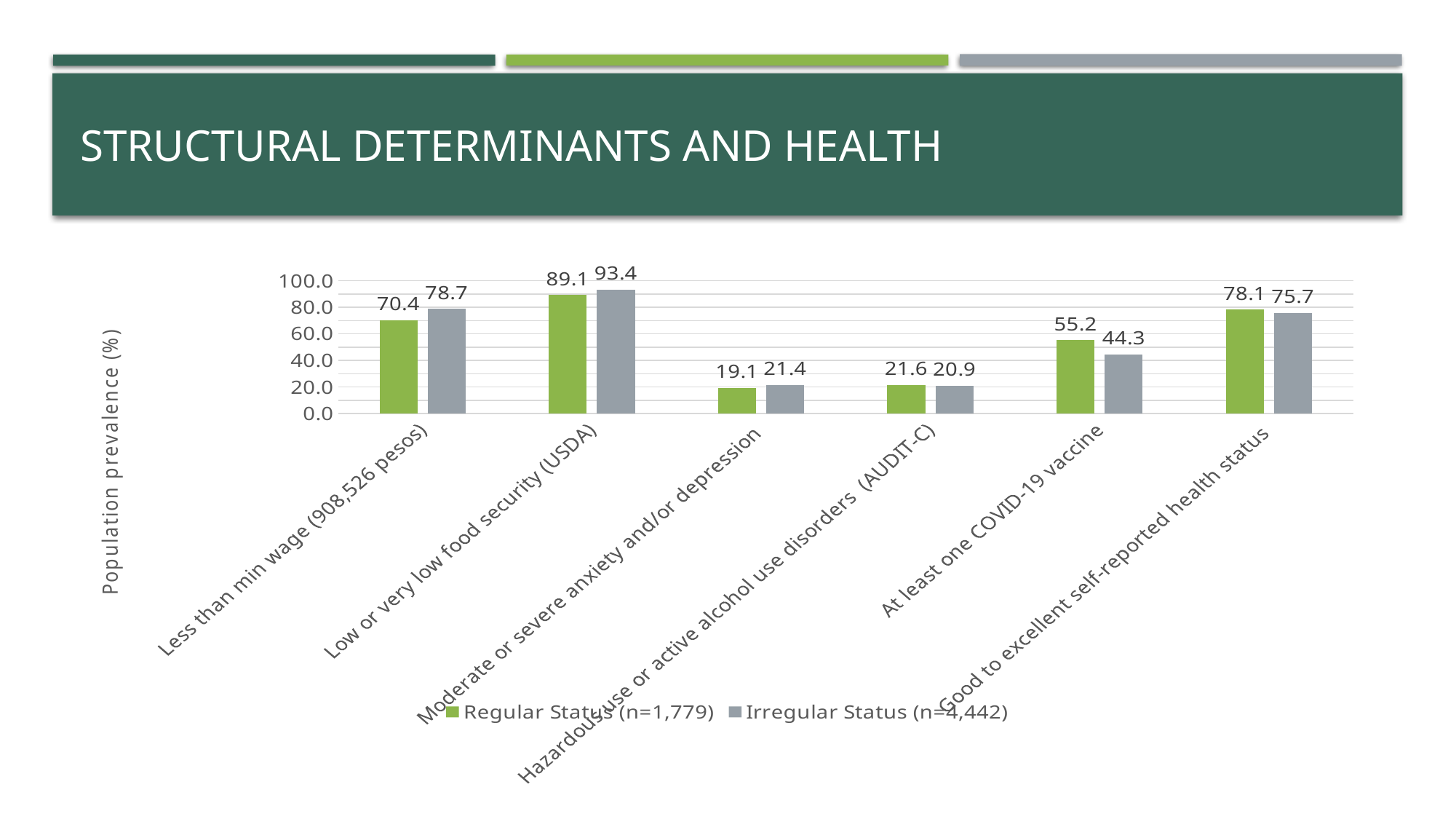
Is the Regular Status value for 'Good to excellent self-reported health status' greater or less than 60.0? greater How many categories are shown on the x axis of the chart? 6 How many series does the legend list? 2 Which category has the lowest value for Irregular Status? Hazardous use or active alcohol use disorders (AUDIT-C) What is the value for Irregular Status in the 'At least one COVID-19 vaccine' category? 44.3 What kind of chart is shown on the slide? Bar chart In the 'Less than min wage (908,526 pesos)' category, which series has the larger value, Regular Status or Irregular Status? Irregular Status What is the difference between the Regular Status and Irregular Status values in the 'At least one COVID-19 vaccine' category? 10.9 Which category has the highest value for Regular Status? Low or very low food security (USDA) What is the label of the vertical axis of the chart? Population prevalence (%) What is the value for Regular Status in the 'Less than min wage (908,526 pesos)' category? 70.4 What is the value for Irregular Status in the 'Low or very low food security (USDA)' category? 93.4